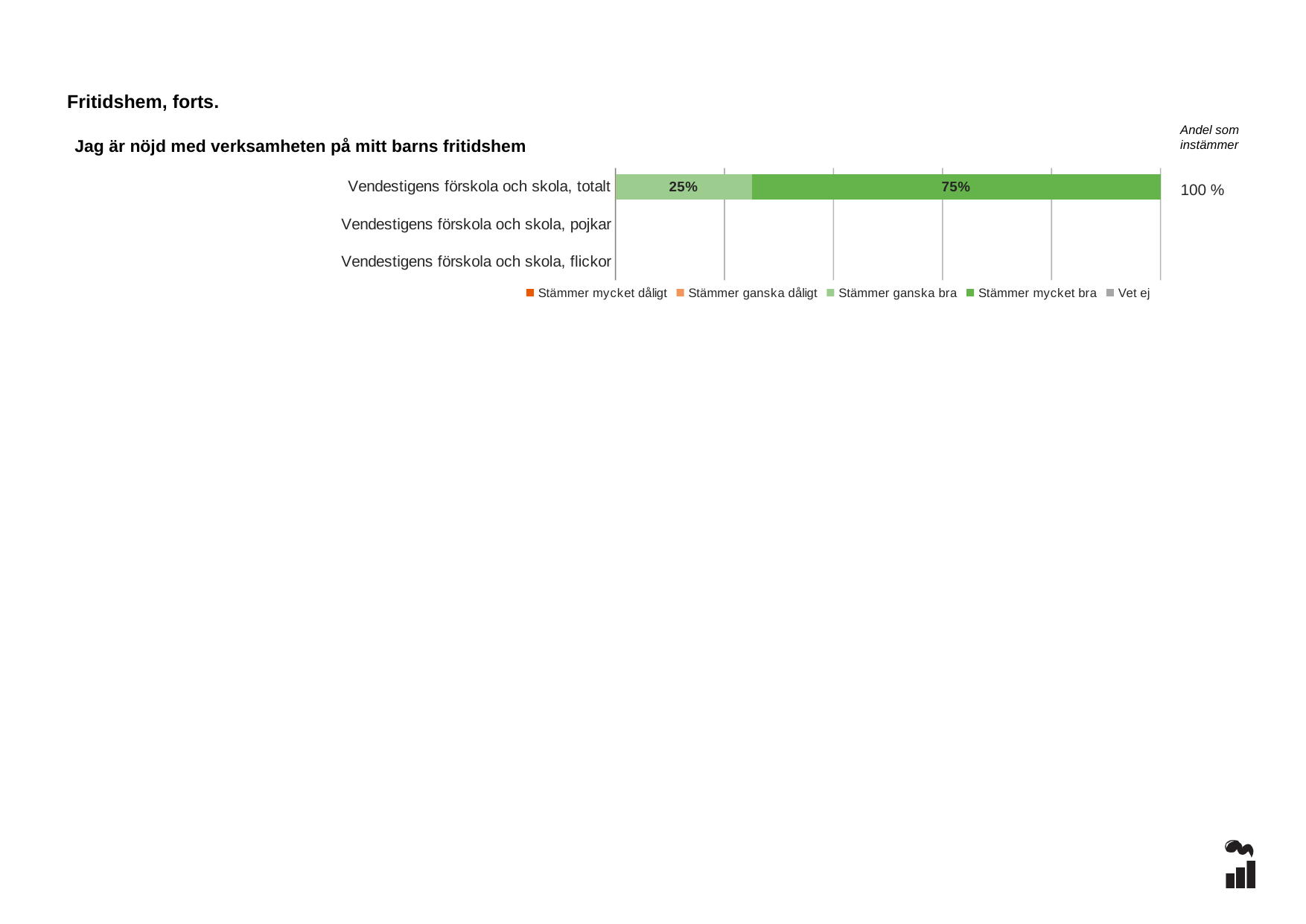
Which rows in the chart have no data plotted? Vendestigens förskola och skola, pojkar and Vendestigens förskola och skola, flickor What percentage of respondents for 'Vendestigens förskola och skola, totalt' answered 'Stämmer mycket bra'? 75% How many response categories does the legend list? 5 What is the combined total of the 'Stämmer ganska bra' and 'Stämmer mycket bra' segments for 'Vendestigens förskola och skola, totalt'? 100% What is the statement shown as the chart title? Jag är nöjd med verksamheten på mitt barns fritidshem Is the 'Stämmer mycket bra' share for 'Vendestigens förskola och skola, totalt' greater or less than 50%? greater What type of chart is shown on the slide? Stacked bar chart What percentage of respondents for 'Vendestigens förskola och skola, totalt' answered 'Stämmer ganska bra'? 25% What is the 'Andel som instämmer' value shown for 'Vendestigens förskola och skola, totalt'? 100 % How many row categories are listed on the vertical axis of the chart? 3 Which response category has the larger share in the 'Vendestigens förskola och skola, totalt' bar: 'Stämmer ganska bra' or 'Stämmer mycket bra'? Stämmer mycket bra What is the difference between the 'Stämmer mycket bra' and 'Stämmer ganska bra' shares for 'Vendestigens förskola och skola, totalt'? 50%